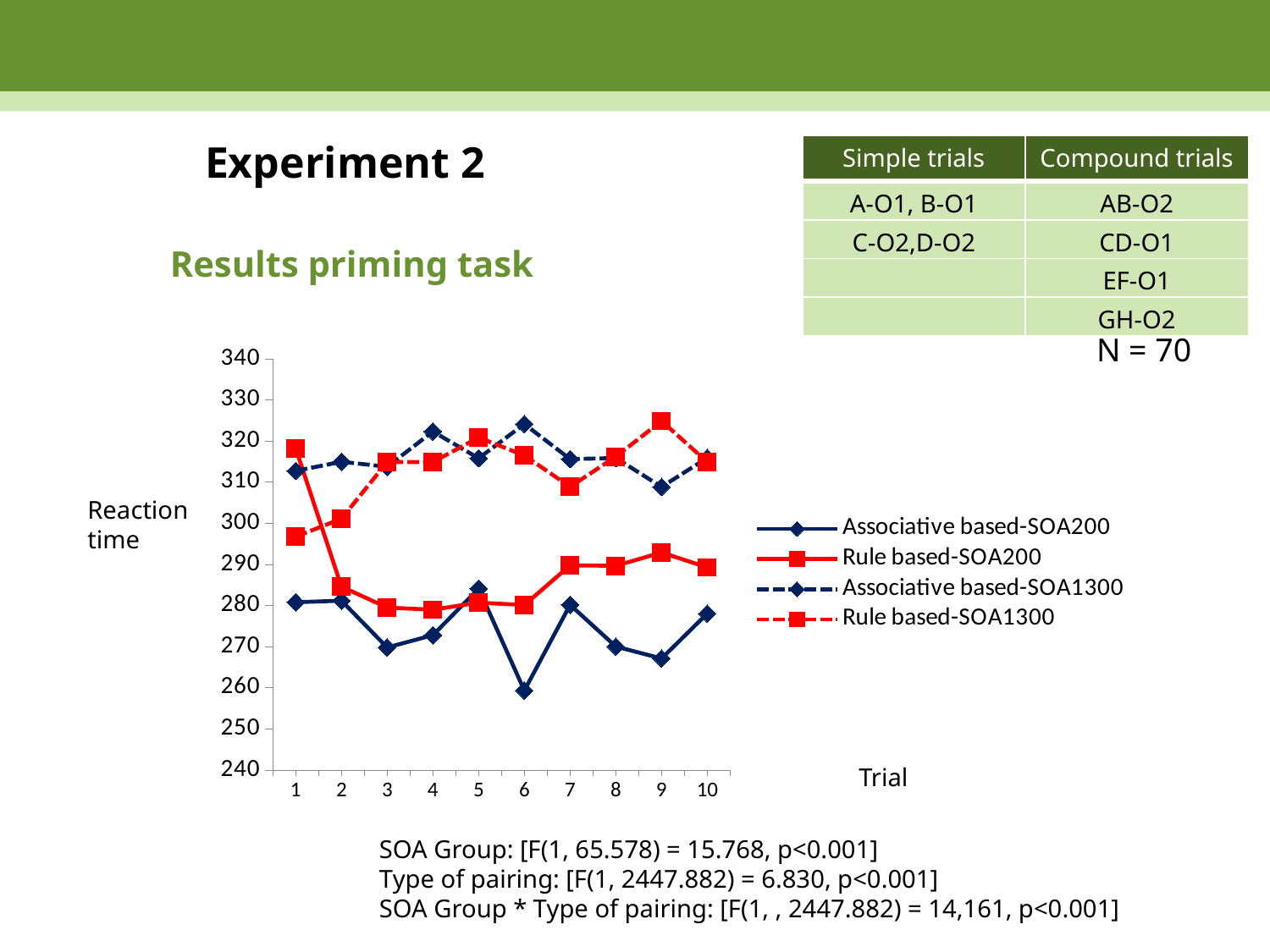
What is the label on the y axis of the chart? Reaction time How many series does the chart's legend list? 4 Is the value for Rule based-SOA200 at trial 1 greater or less than 310? greater Is the value for Associative based-SOA1300 at trial 6 greater or less than 320? greater At trial 1, which is higher: Rule based-SOA200 or Associative based-SOA200? Rule based-SOA200 Which two series are drawn with dashed lines? Associative based-SOA1300 and Rule based-SOA1300 At which trial does the Associative based-SOA200 series reach its lowest value? Trial 6 What kind of chart is shown on the slide? Line chart At which trial does the Rule based-SOA200 series reach its highest value? Trial 1 Does the Rule based-SOA200 series rise or fall from trial 1 to trial 3? Fall Is the value for Associative based-SOA200 at trial 6 greater or less than 270? less How many trials are plotted along the x axis of the chart? 10